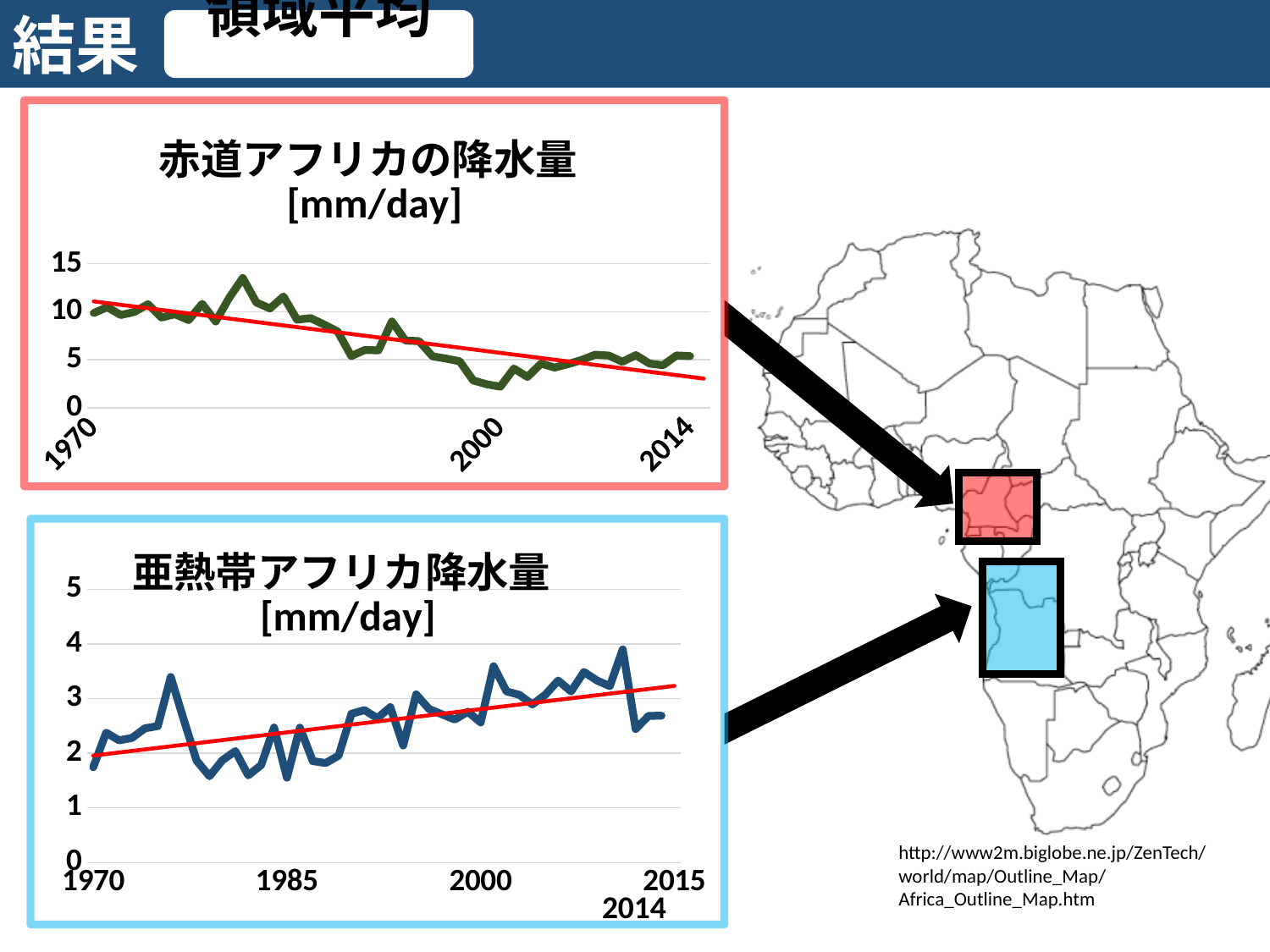
In the top chart (赤道アフリカの降水量), is the lowest point of the green line greater or less than 5? less In the bottom chart (亜熱帯アフリカ降水量), is the lowest point of the blue line greater or less than 2? less In the bottom chart (亜熱帯アフリカ降水量), does the red trend line rise or fall from 1970 to 2015? rise What kind of chart is the bottom chart titled 亜熱帯アフリカ降水量? line chart In the top chart (赤道アフリカの降水量), is the highest peak of the green line greater or less than 10? greater What kind of chart is the top chart titled 赤道アフリカの降水量? line chart In the top chart (赤道アフリカの降水量), does the red trend line rise or fall from 1970 to 2014? fall What is the maximum value shown on the y-axis of the top chart (赤道アフリカの降水量)? 15 What unit is given in the title of the bottom chart (亜熱帯アフリカ降水量)? mm/day